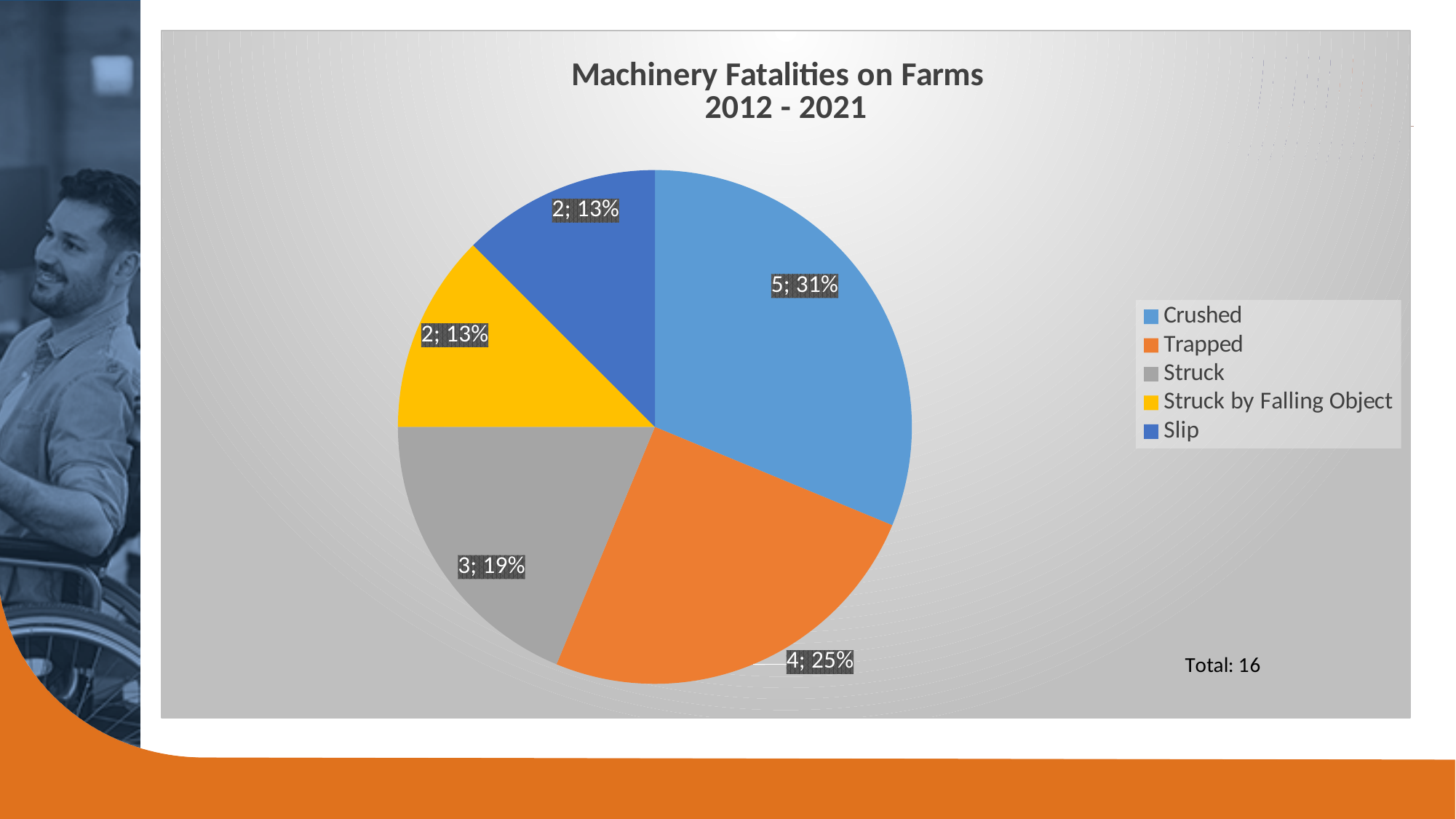
Which is larger, the value for Trapped or the value for Struck by Falling Object? Trapped How many fatalities are attributed to Struck? 3 Which category has the largest slice of the pie? Crushed What percentage share of the pie does Trapped represent? 25% What is the total number of fatalities shown on the slide? 16 What is the title of the chart? Machinery Fatalities on Farms 2012 - 2021 What type of chart is shown on the slide? Pie chart How many fatalities are attributed to Crushed? 5 How many categories does the pie chart have? 5 What is the difference in fatalities between Crushed and Struck? 2 Which category is shown in yellow in the legend? Struck by Falling Object What percentage share of the pie does Slip represent? 13%